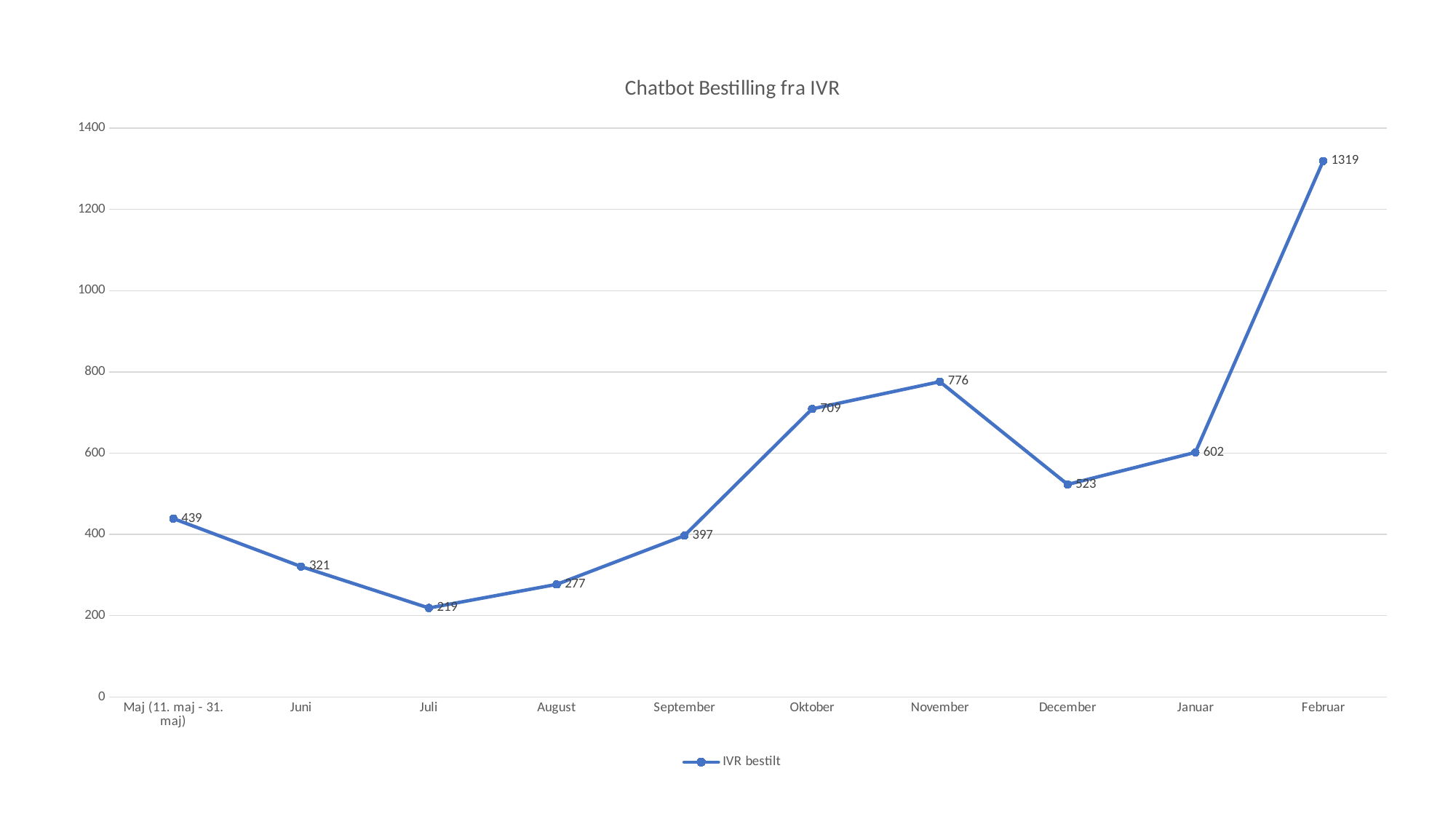
What is the value for Oktober? 709 What is the value for Juli? 219 What is the value for Maj (11. maj - 31. maj)? 439 Which month has the lowest value? Juli Is the value for September greater or less than 400? less Which month has the highest value? Februar Which is larger, the value for November or the value for December? November How many series does the legend list? 1 What kind of chart is shown? line chart What is the difference between the values for Februar and Januar? 717 How many months are plotted on the x axis? 10 What is the title of the chart? Chatbot Bestilling fra IVR